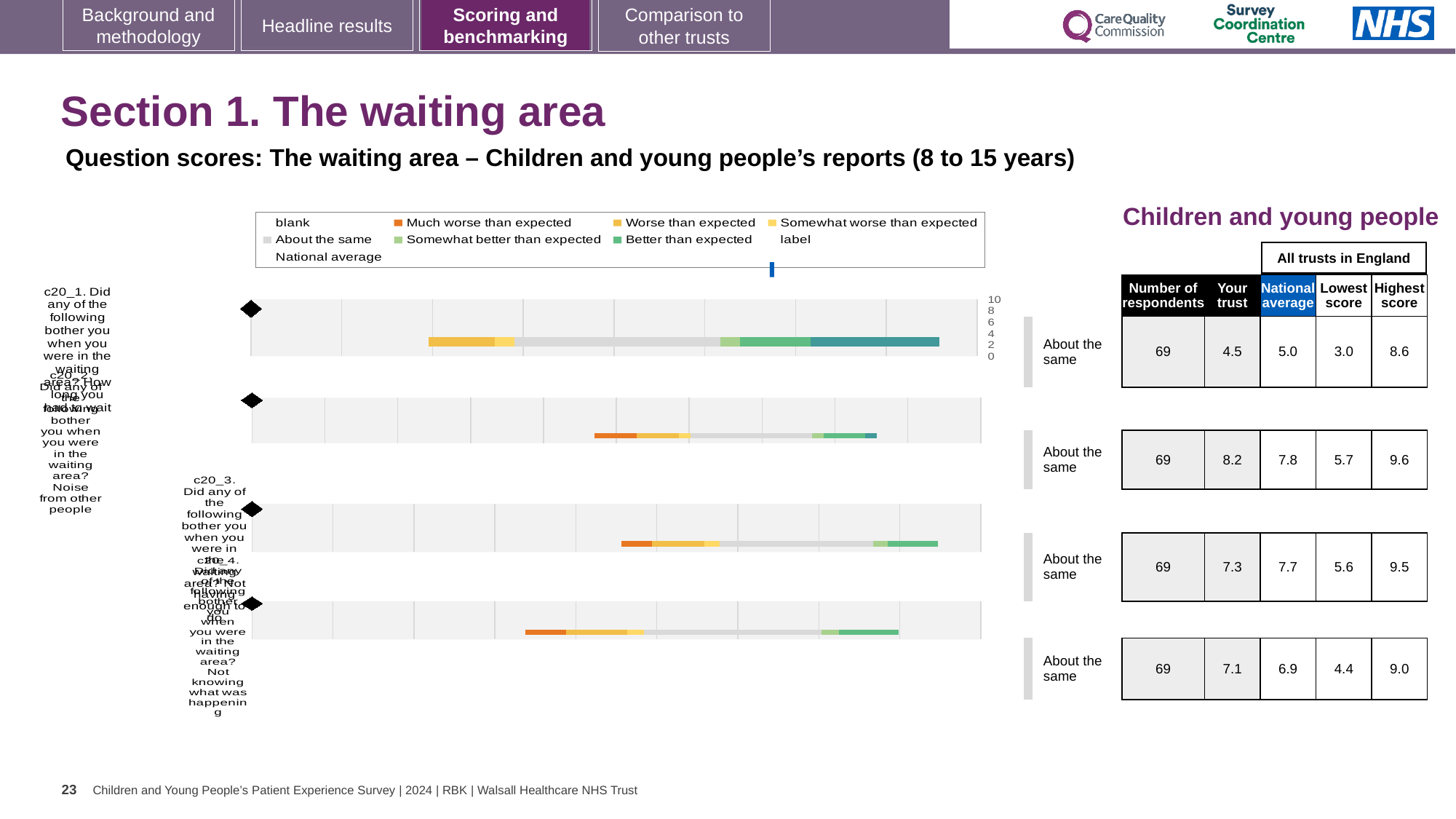
For the third chart row (c20_3), which is larger: the 'Your trust' score or the national average? national average How many respondents are shown for each question row? 69 For the second chart row (c20_2), how much higher is the 'Your trust' score than the national average? 0.4 What benchmark category label is shown next to the fourth chart row (c20_4)? About the same For the second chart row (c20_2, noise from other people), what is the national average score? 7.8 How many entries does the chart legend list? 9 For the first chart row (c20_1, how long you had to wait), what is the 'Your trust' score shown in the table? 4.5 In the chart legend, what colour represents 'Much worse than expected'? orange How many separate bar charts (one per question) are shown on the slide? 4 Which question row has the highest 'Your trust' score? c20_2 (noise from other people) What kind of chart is used to show the question scores on this slide? bar chart Which question row has the lowest 'Your trust' score? c20_1 (how long you had to wait)